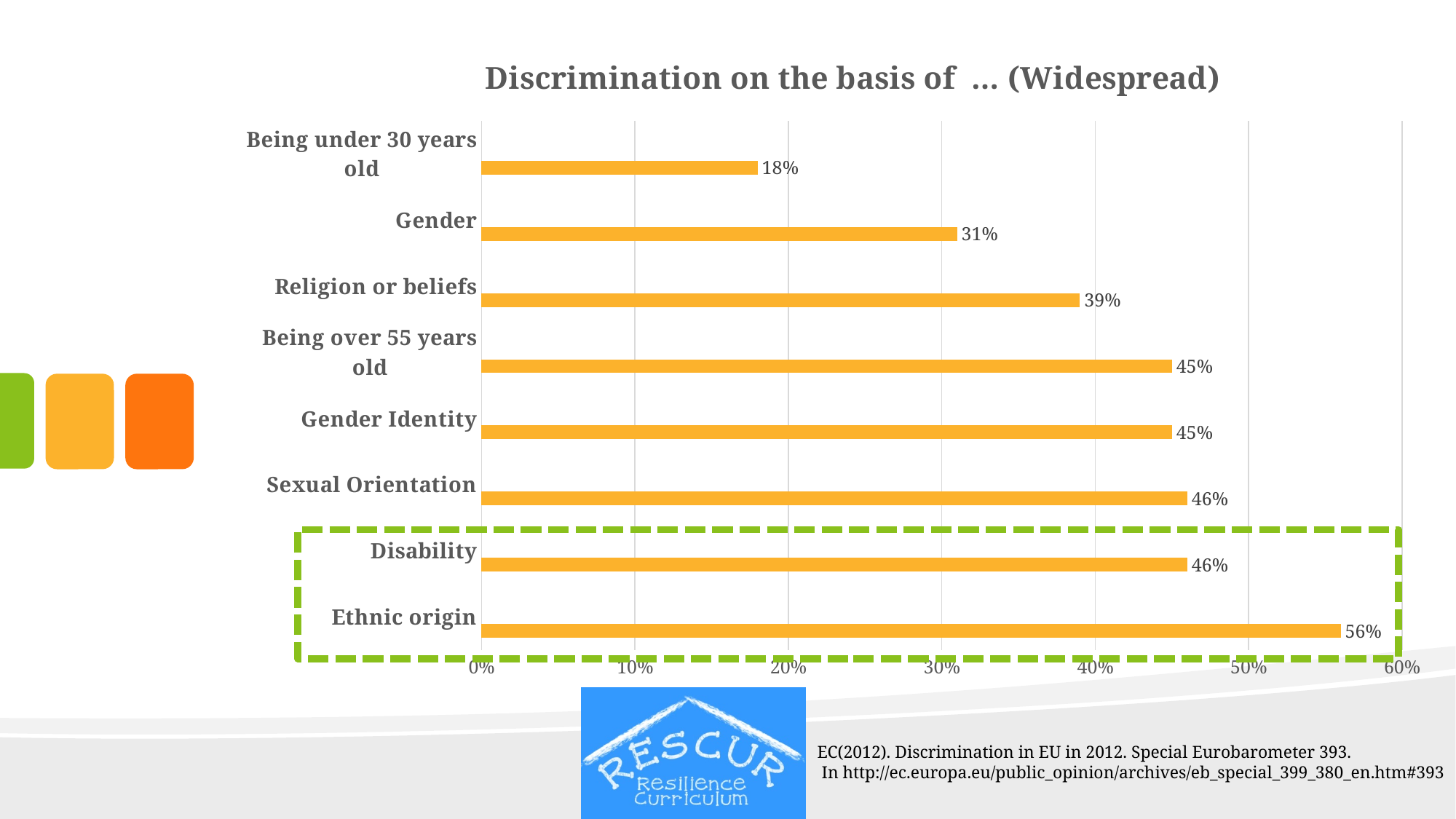
What is the difference between the values for Gender and Being under 30 years old? 13% What is the difference between the values for Ethnic origin and Disability? 10% What is the value for Being under 30 years old? 18% Which is larger, the value for Religion or beliefs or the value for Gender? Religion or beliefs What is the title of the chart? Discrimination on the basis of … (Widespread) Which category has the lowest value? Being under 30 years old What kind of chart is shown on the slide? Bar chart What is the value for Ethnic origin? 56% How many categories are shown in the chart? 8 Which category has the highest value? Ethnic origin What is the value for Gender? 31% What is the value for Religion or beliefs? 39%